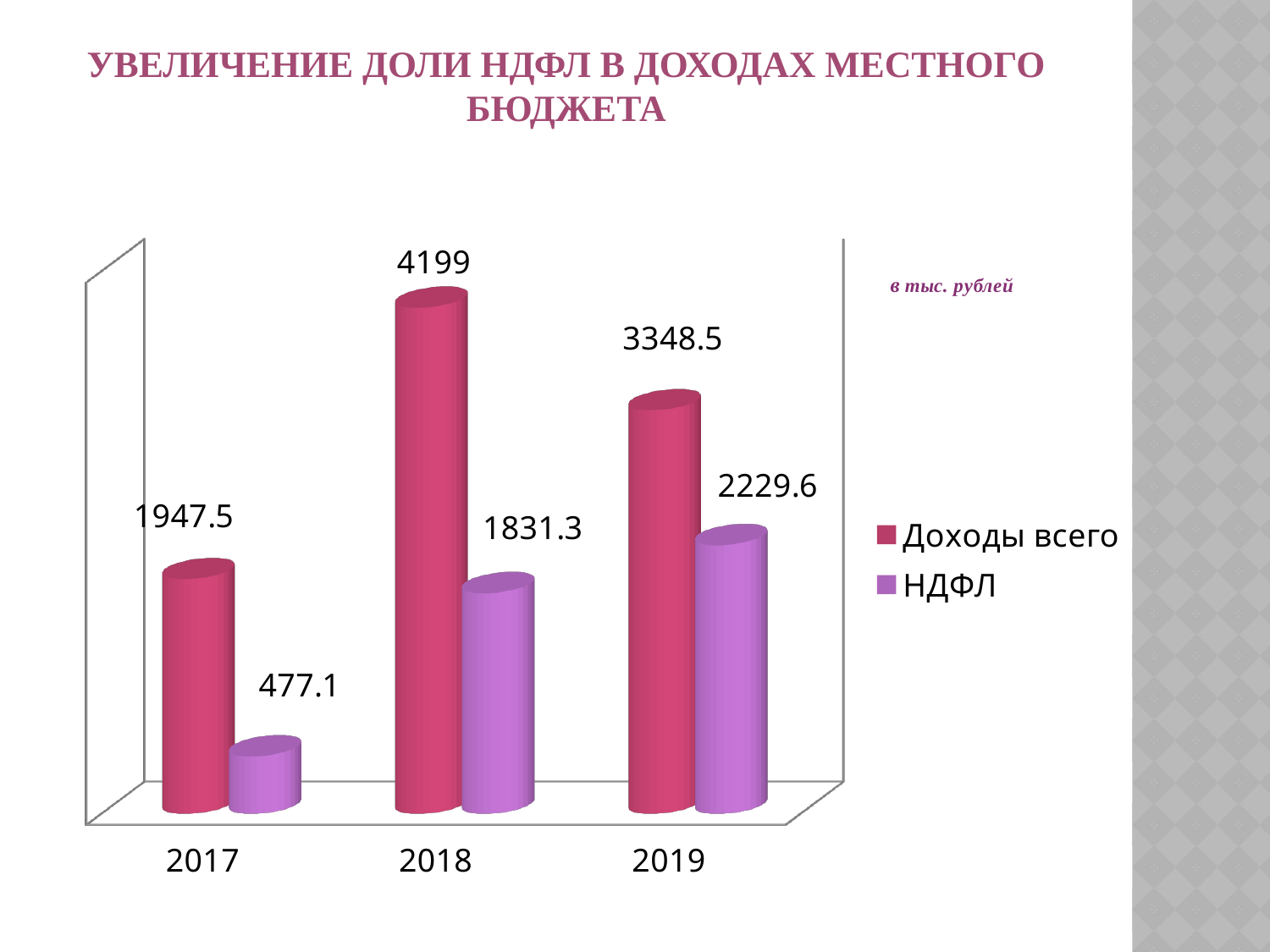
What is the value of НДФЛ for 2017? 477.1 What is the value of НДФЛ for 2019? 2229.6 Which is larger: НДФЛ in 2019 or Доходы всего in 2017? НДФЛ in 2019 How many series does the legend list? 2 In which year is Доходы всего the highest? 2018 In which year is НДФЛ the lowest? 2017 What is the difference between НДФЛ in 2019 and НДФЛ in 2018? 398.3 How many years are shown on the x axis? 3 What is the value of Доходы всего for 2019? 3348.5 Does the value of НДФЛ rise or fall from 2017 to 2019? rise What is the value of Доходы всего for 2018? 4199 What is the difference between Доходы всего and НДФЛ in 2017? 1470.4